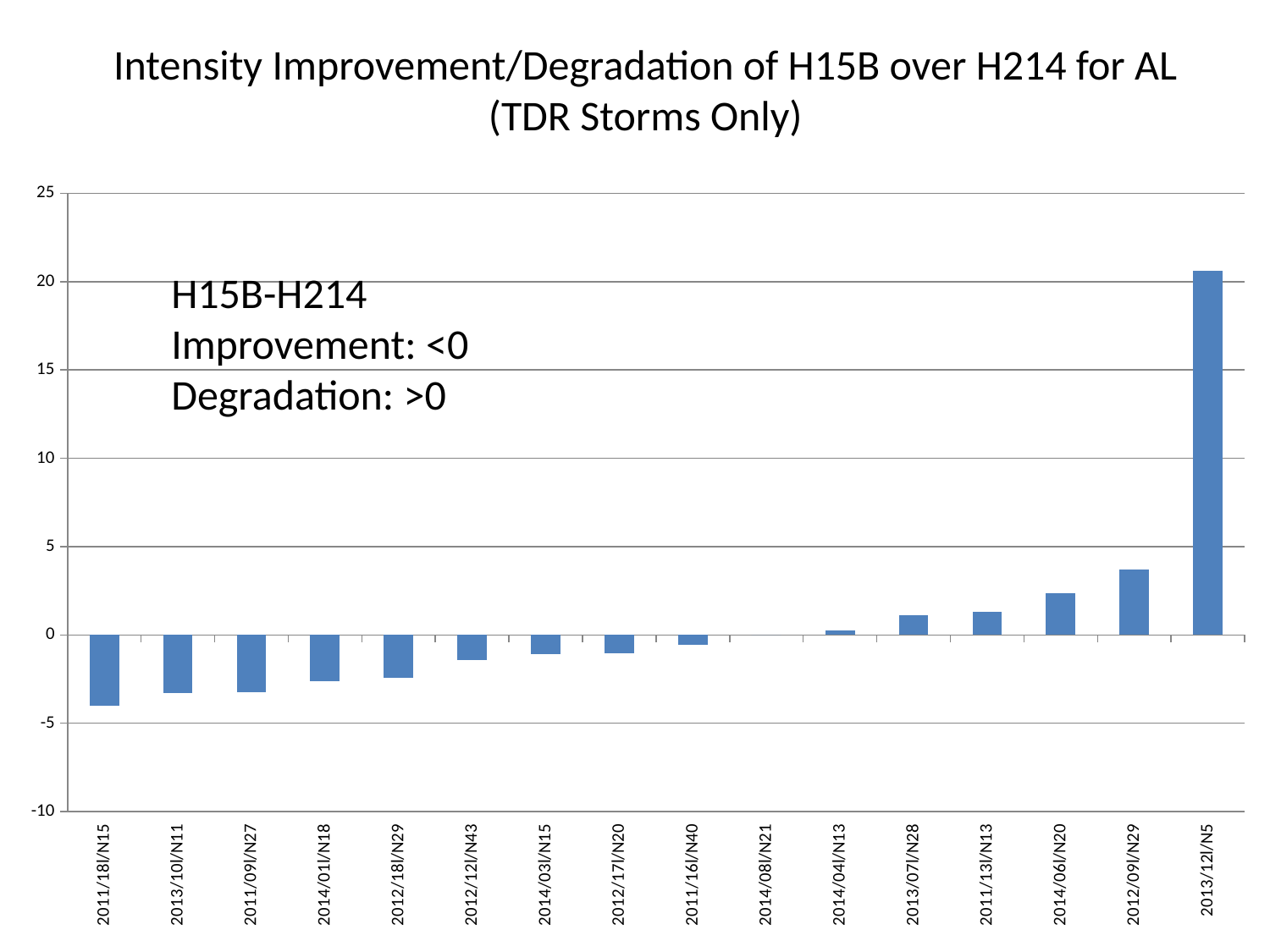
Is the value for 2013/12l/N5 greater or less than 15? greater How many categories (storm cases) are plotted along the x axis? 16 Which category has the highest value? 2013/12l/N5 Is the value for 2011/18l/N15 greater or less than -5? greater Which category has the lowest value? 2011/18l/N15 Is the value for 2014/01l/N18 greater or less than 0? less What kind of chart is shown on the slide? bar chart Do the values generally rise or fall moving from left to right along the x axis? rise Which has the larger value, 2011/18l/N15 or 2014/06l/N20? 2014/06l/N20 According to the text on the chart, does a value below 0 indicate improvement or degradation? Improvement Which has the larger value, 2013/12l/N5 or 2012/09l/N29? 2013/12l/N5